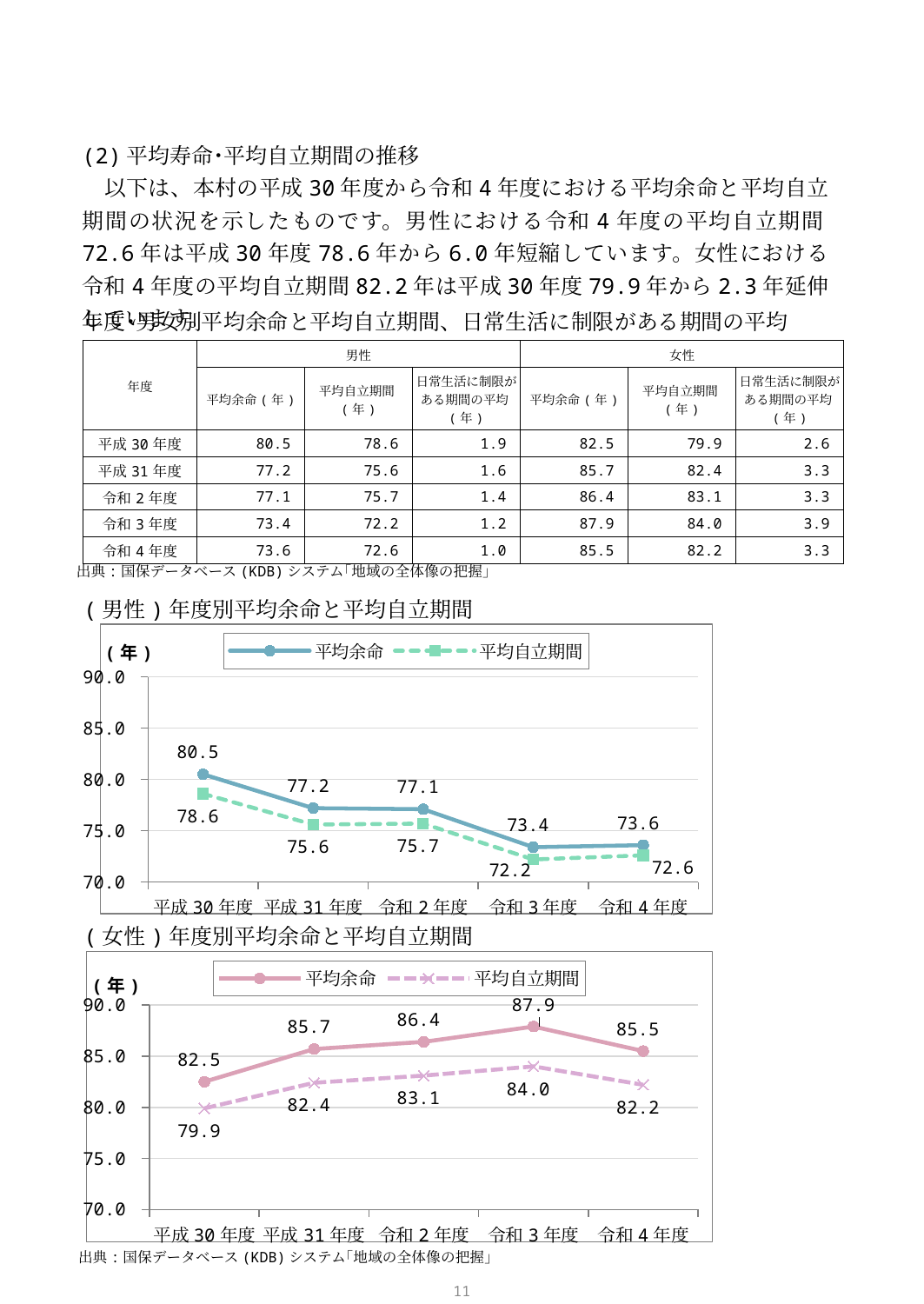
In the (女性) chart, what is the 平均余命 value for 令和3年度? 87.9 In the (男性) chart, what is the 平均余命 value for 平成30年度? 80.5 In the (男性) chart, which year has the lowest 平均自立期間 value? 令和3年度 What kind of chart is the (男性) 年度別平均余命と平均自立期間 chart? line chart In the (女性) chart, what is the 平均自立期間 value for 平成30年度? 79.9 In the (女性) chart, what is the difference between the 平均余命 values for 令和3年度 and 令和4年度? 2.4 How many series does the legend of the (女性) chart list? 2 In the (男性) chart, what is the 平均自立期間 value for 令和4年度? 72.6 In the (女性) chart, is the 平均自立期間 value for 令和2年度 larger or smaller than the 平均自立期間 value for 平成31年度? larger In the (女性) chart, which year has the highest 平均余命 value? 令和3年度 In the (男性) chart, what is the difference between the 平均余命 and 平均自立期間 values for 平成30年度? 1.9 In the (男性) chart, does the 平均余命 series generally rise or fall from 平成30年度 to 令和4年度? fall